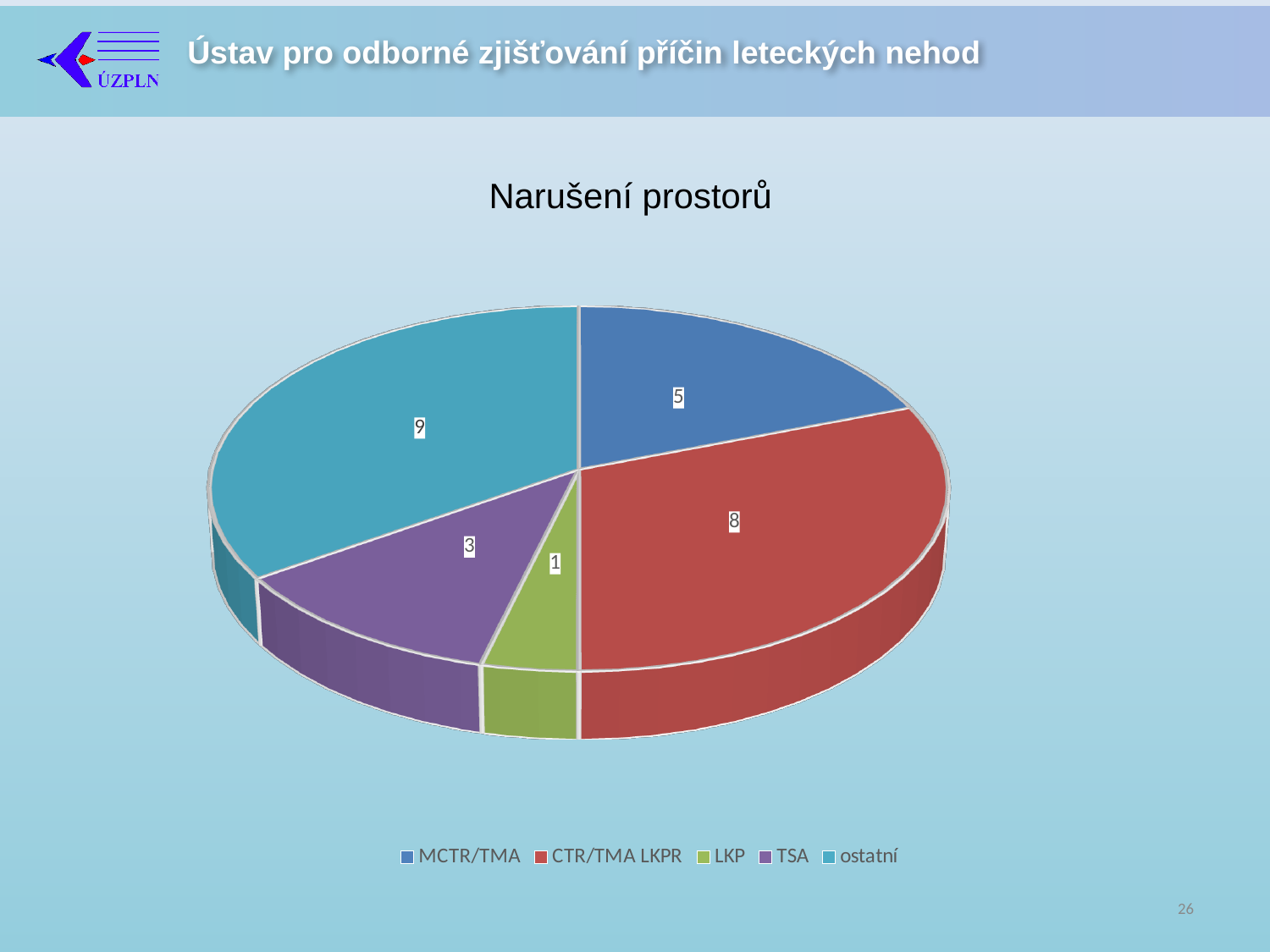
What is the value for ostatní? 9 What is the title of the chart? Narušení prostorů What is the value for MCTR/TMA? 5 What type of chart is shown on the slide? pie chart What is the difference between the values for ostatní and MCTR/TMA? 4 Which category has the largest slice? ostatní Which is larger, the value for CTR/TMA LKPR or the value for TSA? CTR/TMA LKPR What is the value for CTR/TMA LKPR? 8 What is the value for TSA? 3 Which category has the smallest slice? LKP How many categories does the pie chart have? 5 What is the total of all slices in the pie chart? 26